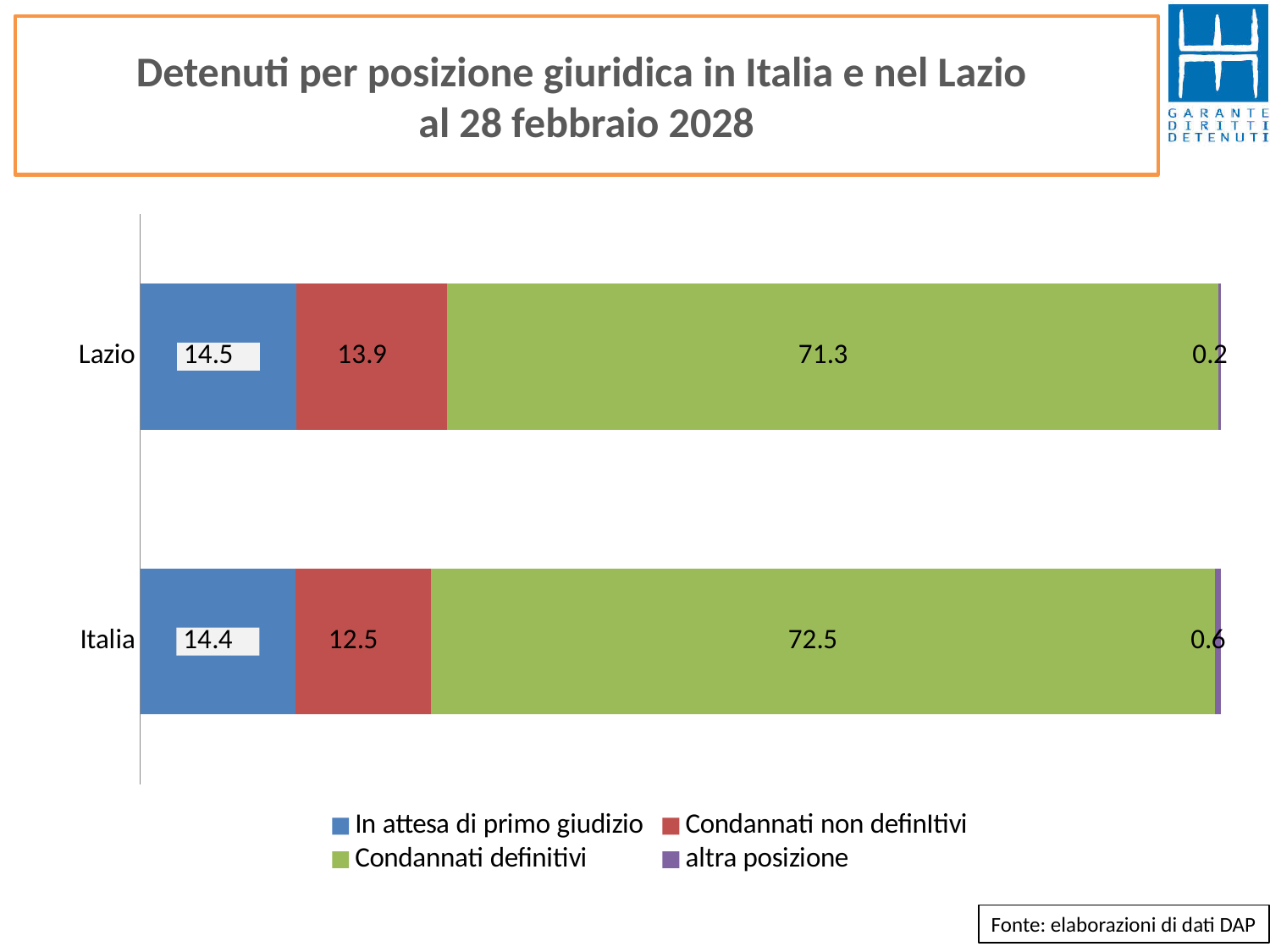
Which is larger, the 'Condannati definitivi' value for Italia or for Lazio? Italia What is the value for 'Condannati definitivi' in Lazio? 71.3 Which series has the smallest value in the Lazio bar? altra posizione What is the value for 'Condannati non definitivi' in Lazio? 13.9 How many series does the legend list? 4 Which series has the largest value in the Italia bar? Condannati definitivi What is the total of the stacked bar for Lazio? 99.9 What kind of chart is shown on the slide? Stacked bar chart What is the difference between the 'Condannati non definitivi' values for Lazio and Italia? 1.4 How many categories (bars) are plotted in the chart? 2 What is the value for 'In attesa di primo giudizio' in Italia? 14.4 What is the value for 'altra posizione' in Italia? 0.6